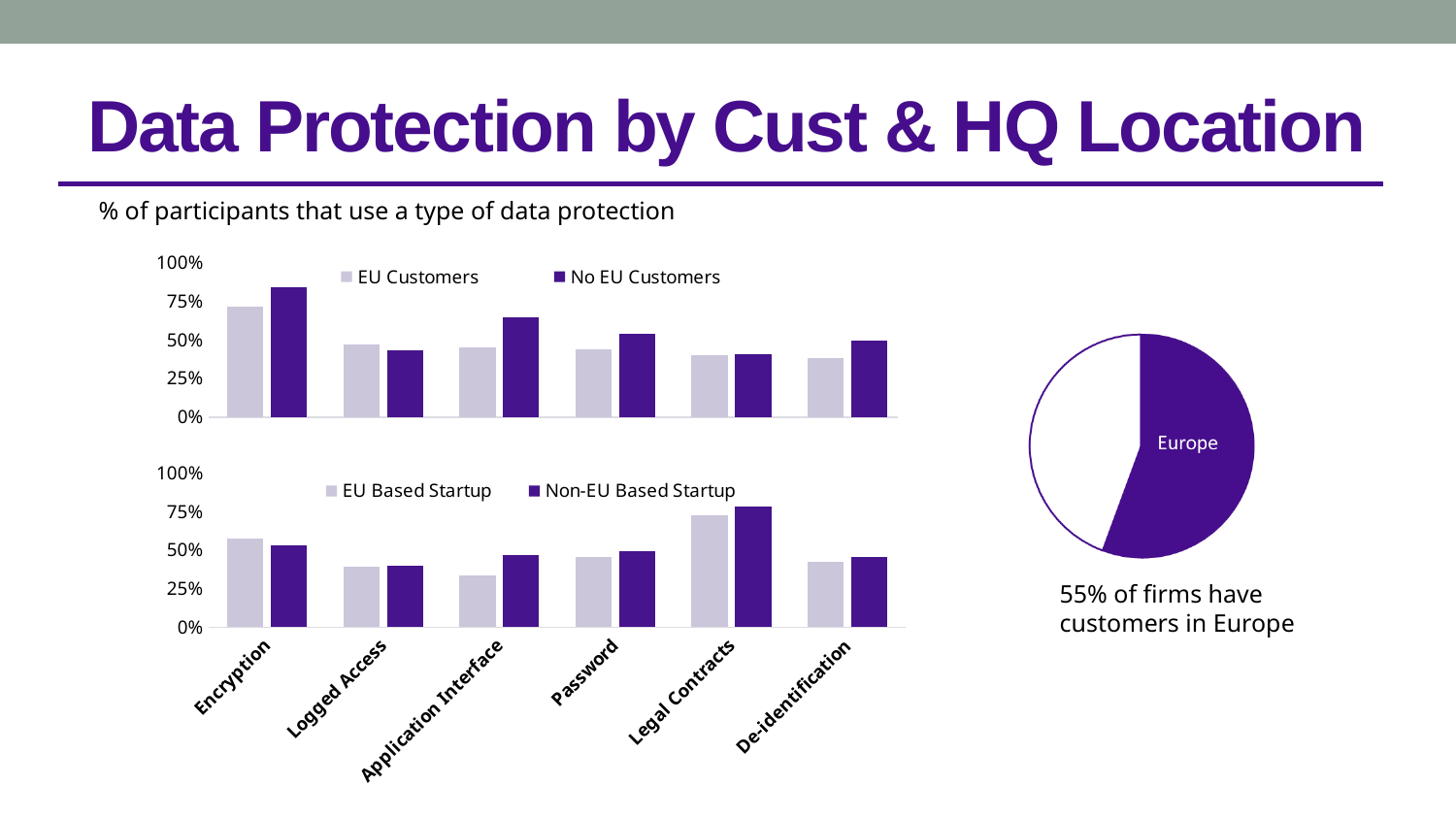
How many data protection categories are shown along the x axis of the bar charts? 6 In the bottom bar chart (EU Based Startup vs Non-EU Based Startup), which category has the highest value for Non-EU Based Startup? Legal Contracts In the bottom bar chart, is the EU Based Startup value for Legal Contracts greater or less than 50%? greater In the pie chart on the right, what share of firms does the Europe slice represent? 55% In the bottom bar chart, is the EU Based Startup value for Application Interface greater or less than 50%? less How many series does the legend of the top bar chart list? 2 What kind of chart is shown on the right side of the slide? pie chart In the bottom bar chart, which category has the lowest value for EU Based Startup? Application Interface